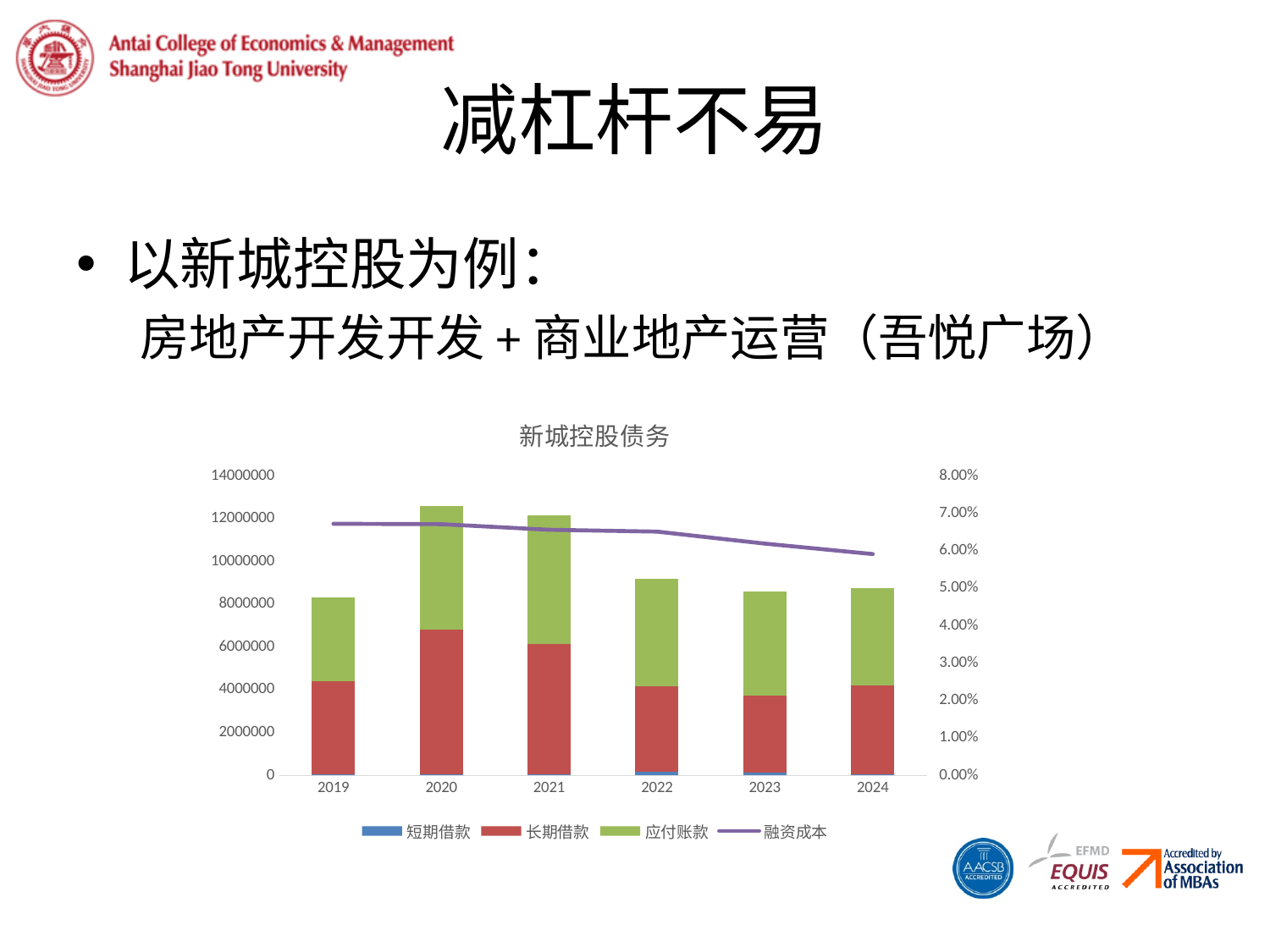
Is the total stacked bar for 2021 greater or less than 10000000? greater Is the total stacked bar for 2020 greater or less than 12000000? greater Which series is plotted as a line in the chart? 融资成本 Is the 融资成本 value for 2019 greater or less than 6.00%? greater What kind of chart is shown on the slide? stacked bar chart with a line How many years are shown on the x axis of the chart? 6 How many series does the chart legend list? 4 Which year has the tallest stacked bar in the chart? 2020 Which is larger, the 长期借款 value for 2020 or for 2019? 2020 What is the title of the chart? 新城控股债务 Does the 融资成本 line rise or fall from 2019 to 2024? fall